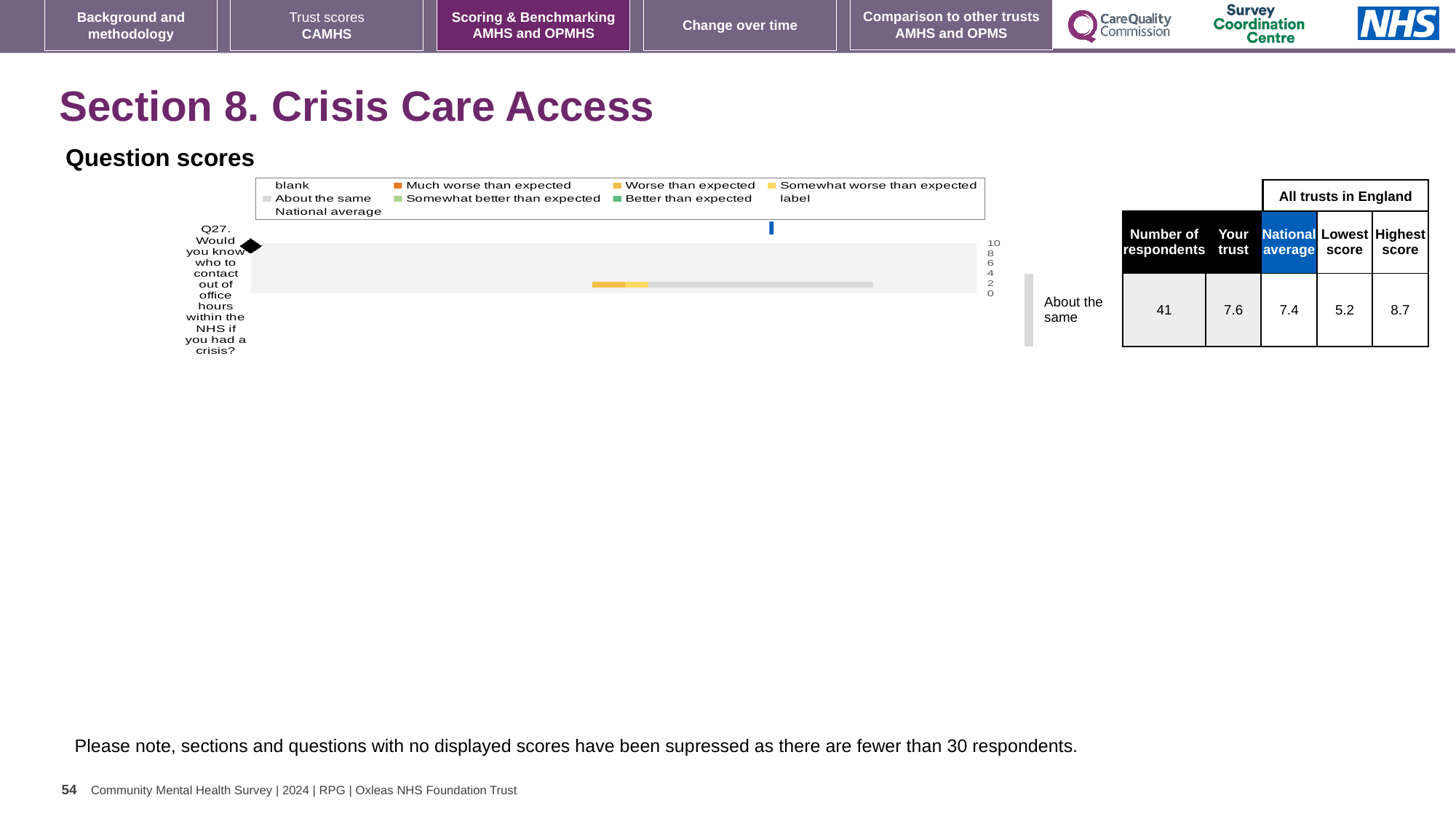
In the table beside the chart, what is the national average score for Q27? 7.4 How many entries does the legend of the Question scores chart list? 9 In the table beside the chart, what is the "Your trust" score for Q27? 7.6 What is the highest tick value shown on the axis of the Question scores chart? 10 Which question is plotted in the Question scores chart? Q27. Would you know who to contact out of office hours within the NHS if you had a crisis? How many questions (categories) are plotted in the Question scores chart? 1 What kind of chart is shown under "Question scores"? bar chart In the table beside the chart, what is the highest score among all trusts in England for Q27? 8.7 What benchmark category is shown next to the bar for Q27? About the same In the table beside the chart, what is the number of respondents for Q27? 41 Which is larger for Q27, the "Your trust" score or the national average? Your trust In the table beside the chart, what is the lowest score among all trusts in England for Q27? 5.2